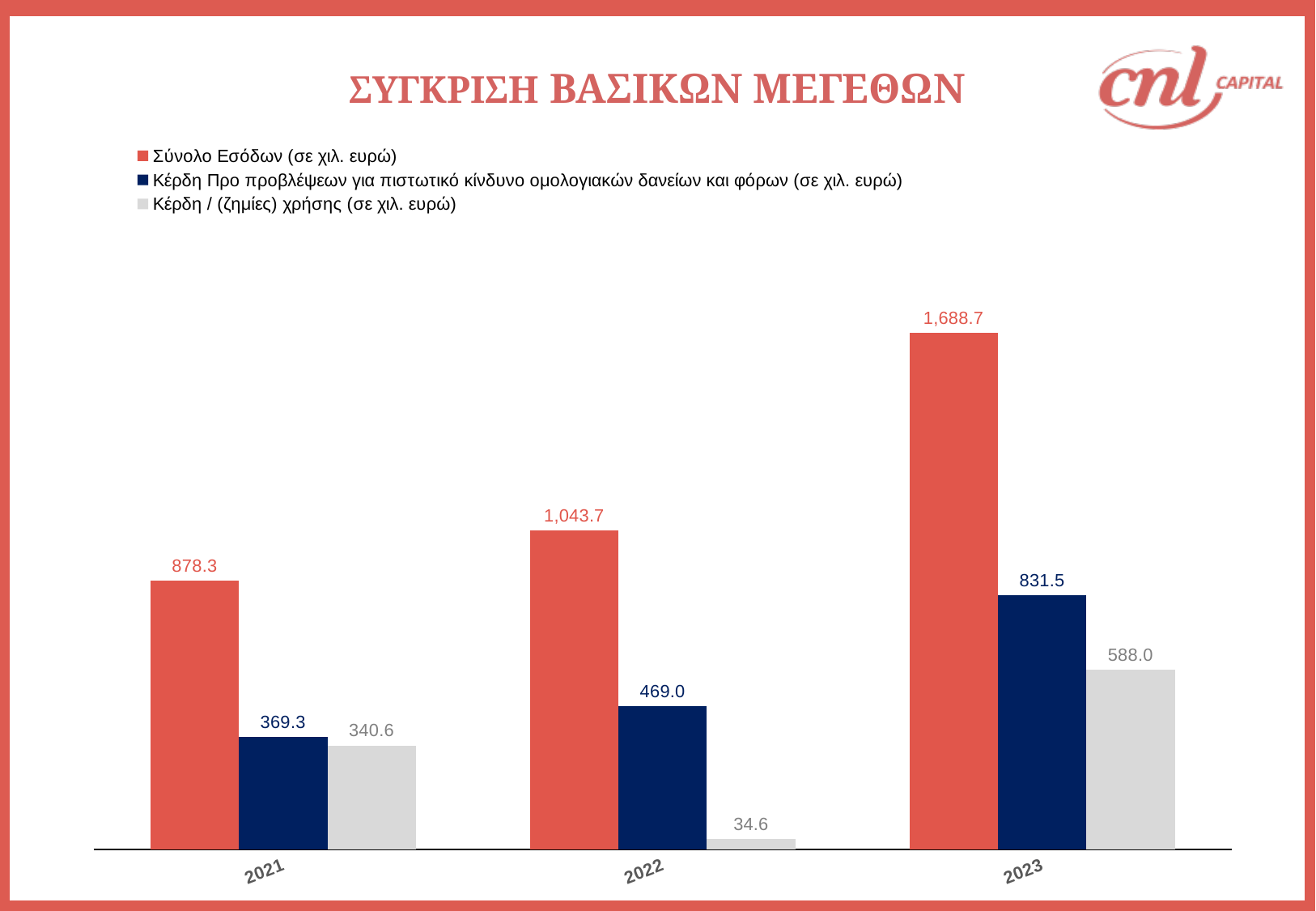
What is the difference between Σύνολο Εσόδων in 2023 and in 2022? 645.0 What is the value of Σύνολο Εσόδων (σε χιλ. ευρώ) for 2023? 1,688.7 In which year is Κέρδη / (ζημίες) χρήσης (σε χιλ. ευρώ) the lowest? 2022 In which year is Σύνολο Εσόδων (σε χιλ. ευρώ) the highest? 2023 How many years are shown on the x axis? 3 Which is larger: Κέρδη Προ προβλέψεων in 2021 or Κέρδη / (ζημίες) χρήσης in 2021? Κέρδη Προ προβλέψεων in 2021 What is the difference between Κέρδη Προ προβλέψεων in 2023 and Κέρδη / (ζημίες) χρήσης in 2023? 243.5 What is the value of Κέρδη Προ προβλέψεων για πιστωτικό κίνδυνο ομολογιακών δανείων και φόρων (σε χιλ. ευρώ) for 2021? 369.3 What is the value of Κέρδη / (ζημίες) χρήσης (σε χιλ. ευρώ) for 2022? 34.6 Does Σύνολο Εσόδων (σε χιλ. ευρώ) rise or fall from 2021 to 2023? Rise How many series does the legend list? 3 What kind of chart is shown on the slide? Bar chart